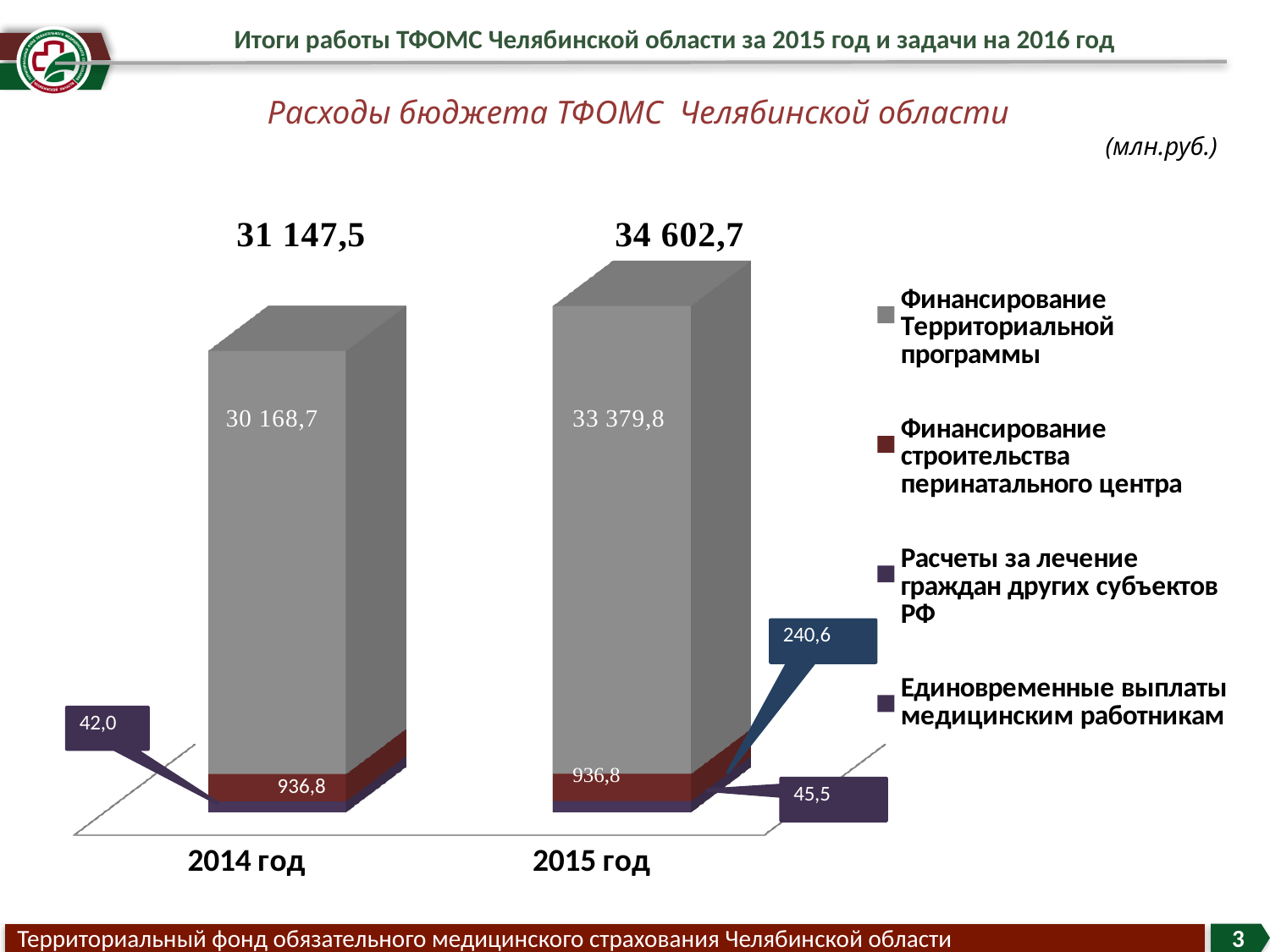
What is the value of Единовременные выплаты медицинским работникам for 2015 год? 45,5 Which year has the larger total budget expenditure, 2014 год or 2015 год? 2015 год What is the value of Финансирование Территориальной программы for 2015 год? 33 379,8 What type of chart is shown on the slide? Stacked bar chart What is the value of Расчеты за лечение граждан других субъектов РФ for 2015 год? 240,6 What is the total value shown above the bar for 2014 год? 31 147,5 By how much did Финансирование Территориальной программы increase from 2014 год to 2015 год? 3 211,1 What is the value of Финансирование Территориальной программы for 2014 год? 30 168,7 What is the total value shown above the bar for 2015 год? 34 602,7 How many categories (years) are shown on the x axis? 2 How many series does the legend list? 4 What is the value of Финансирование строительства перинатального центра for 2014 год? 936,8